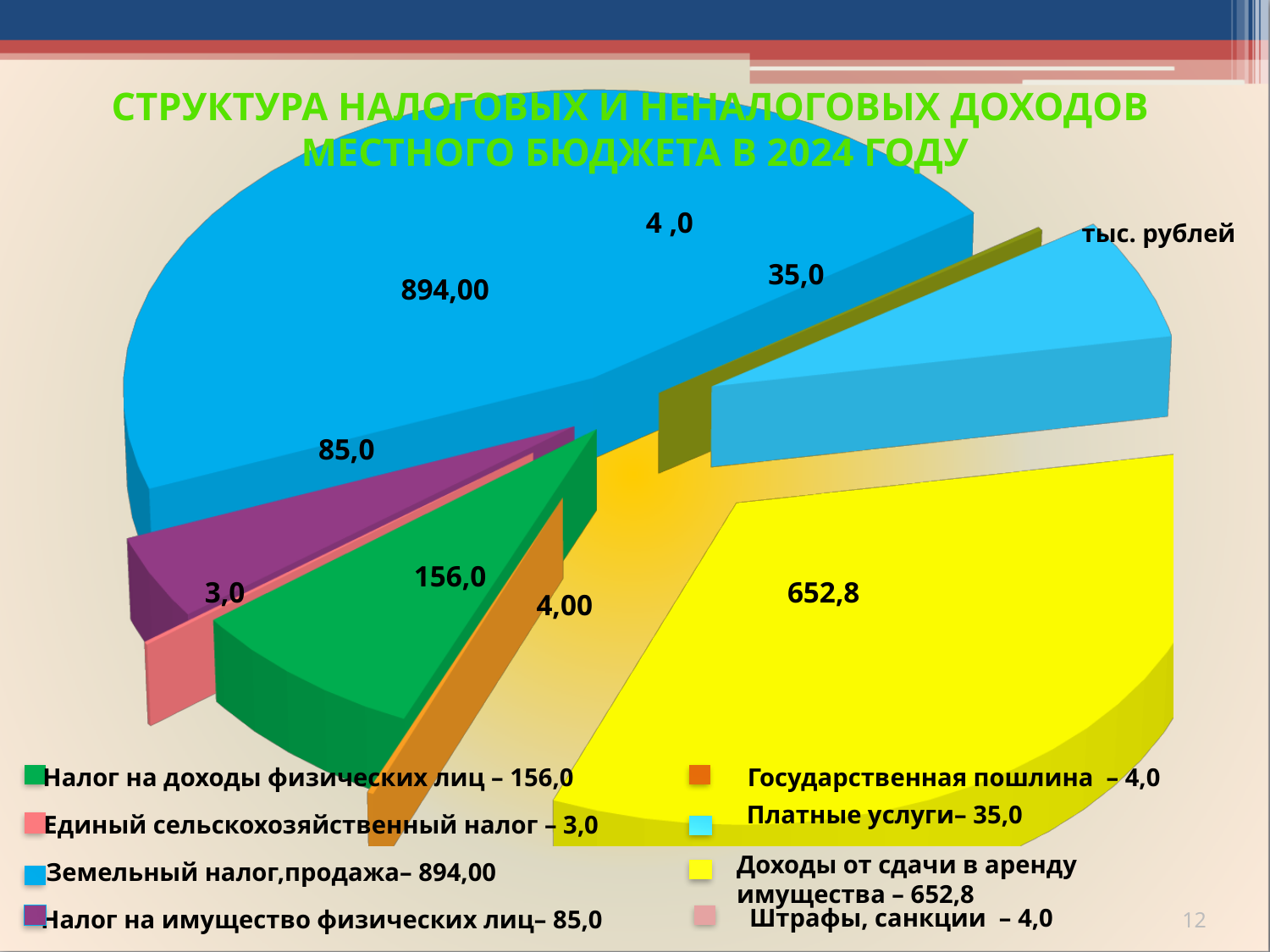
What is the value for Доходы от сдачи в аренду имущества? 652,8 What is the value for Платные услуги? 35,0 How many categories does the pie chart show? 8 Which category has the smallest value in the pie chart? Единый сельскохозяйственный налог What is the value for Налог на имущество физических лиц? 85,0 What is the value for Налог на доходы физических лиц? 156,0 What type of chart is shown on the slide? Pie chart In what units are the values on the chart given? тыс. рублей Which category has the largest value in the pie chart? Земельный налог,продажа What is the value for Земельный налог,продажа? 894,00 Which is larger: Доходы от сдачи в аренду имущества or Налог на доходы физических лиц? Доходы от сдачи в аренду имущества What is the difference between the values for Земельный налог,продажа and Доходы от сдачи в аренду имущества? 241,2